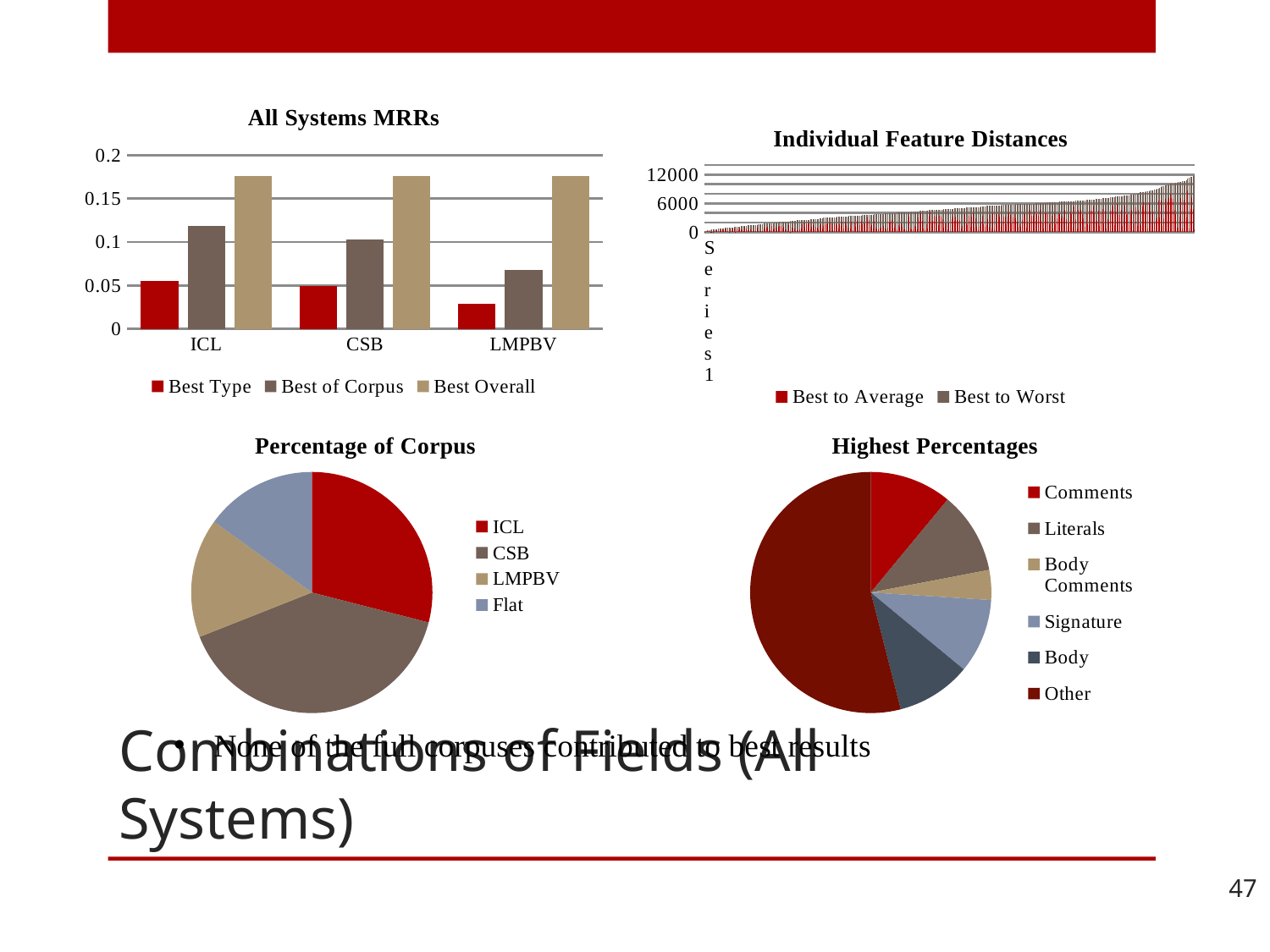
In the "All Systems MRRs" chart, is the Best of Corpus value for ICL greater or less than 0.1? greater How many series does the legend of the "Individual Feature Distances" chart list? 2 In the "Percentage of Corpus" pie chart, which slice is the largest? CSB In the "Individual Feature Distances" chart, do the values rise or fall from left to right along the x axis? rise How many categories are shown on the x axis of the "All Systems MRRs" chart? 3 In the "All Systems MRRs" chart, which is larger for ICL: Best Type or Best of Corpus? Best of Corpus In the "Highest Percentages" pie chart, which slice is the smallest? Body Comments What kind of chart is the "All Systems MRRs" chart? bar chart How many series does the legend of the "All Systems MRRs" chart list? 3 In the "All Systems MRRs" chart, is the Best Overall value for ICL greater or less than 0.15? greater In the "All Systems MRRs" chart, which category has the lowest Best of Corpus value? LMPBV In the "All Systems MRRs" chart, is the Best Type value for LMPBV greater or less than 0.05? less